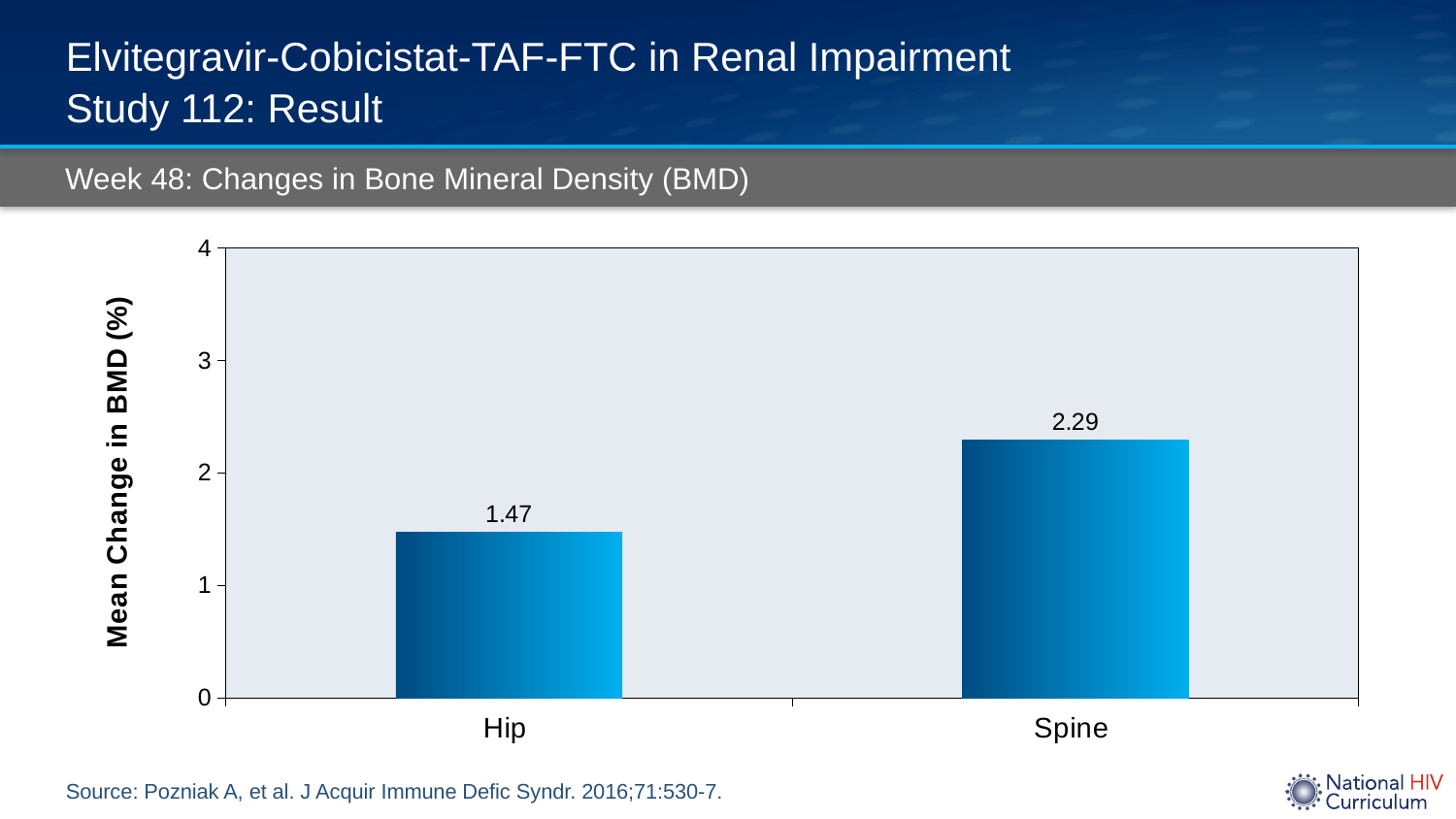
Which category has the highest mean change in BMD? Spine What is the maximum value shown on the y axis? 4 What is the difference between the mean change in BMD for Spine and Hip? 0.82 Is the value for Hip greater or less than 2? less What is the label of the y axis? Mean Change in BMD (%) What is the mean change in BMD for Spine? 2.29 Which has a larger mean change in BMD, Hip or Spine? Spine What kind of chart is shown on the slide? bar chart Which category has the lowest mean change in BMD? Hip How many categories are shown on the x axis? 2 Is the value for Spine greater or less than 2? greater What is the mean change in BMD for Hip? 1.47